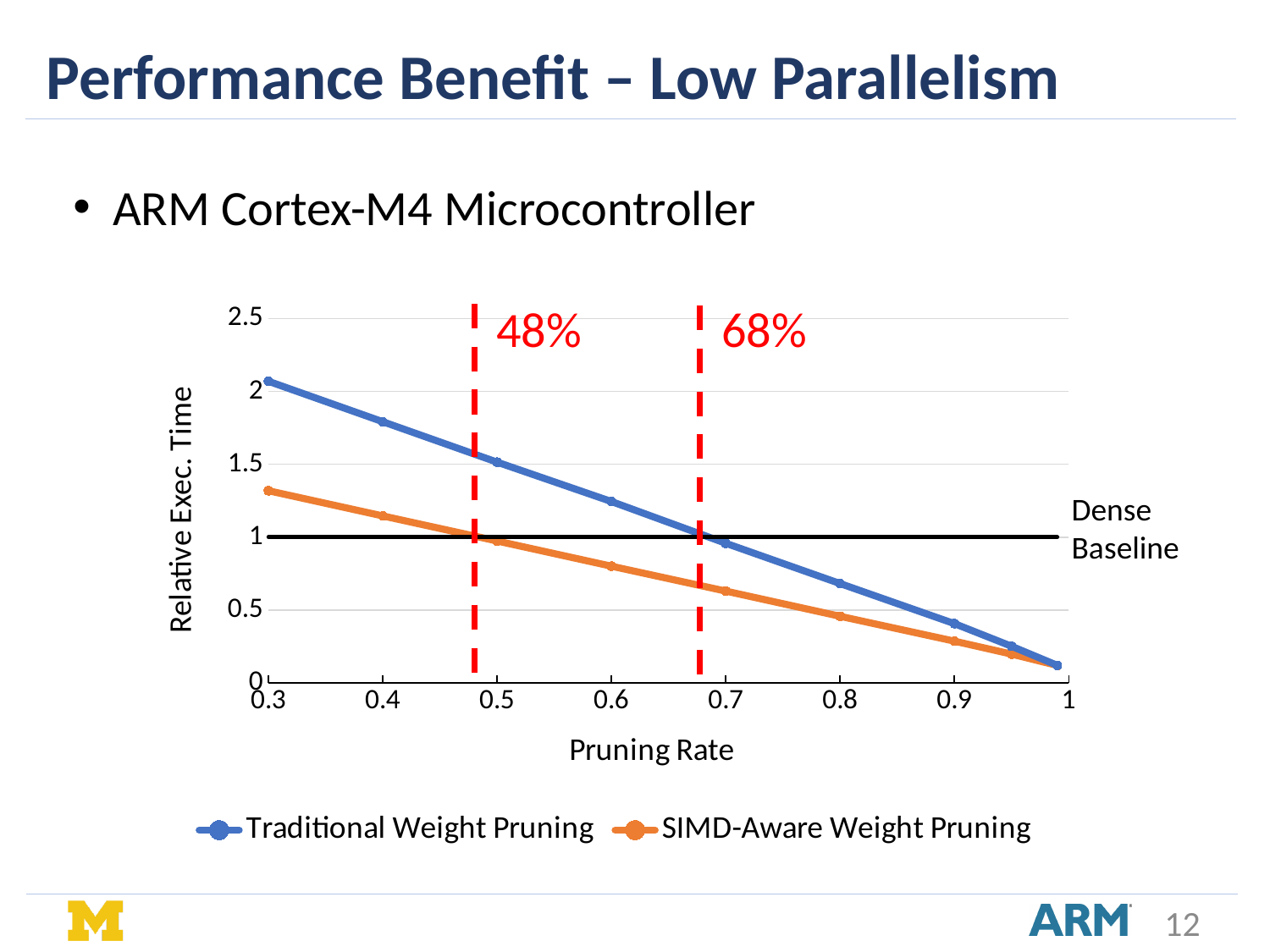
Is the value for Traditional Weight Pruning at a pruning rate of 0.9 greater or less than 0.5? less What is the title of the x axis? Pruning Rate Is the value for SIMD-Aware Weight Pruning at a pruning rate of 0.6 greater or less than 1? less Is the value for SIMD-Aware Weight Pruning at a pruning rate of 0.3 greater or less than 1.5? less What kind of chart is shown on the slide? line chart How many series does the legend list? 2 Does the relative execution time for Traditional Weight Pruning rise or fall as the pruning rate increases? fall At what relative execution time is the Dense Baseline line drawn? 1 According to the red annotation, at what pruning rate does the SIMD-Aware Weight Pruning line cross the Dense Baseline? 48% At a pruning rate of 0.5, which series has the higher relative execution time? Traditional Weight Pruning